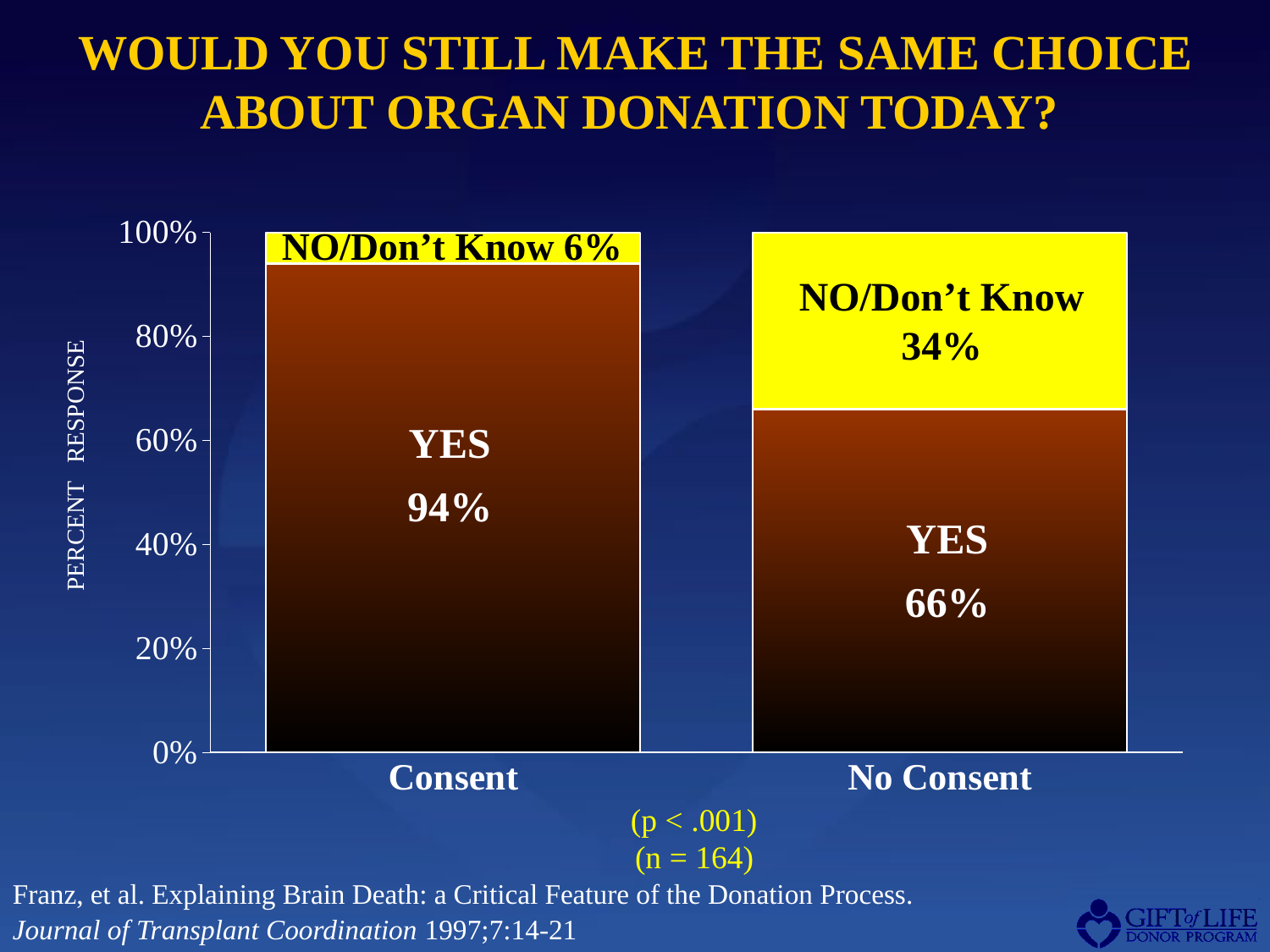
What is the difference in YES percentage between the Consent and No Consent groups? 28% What is the label of the y axis? PERCENT RESPONSE What percentage of the No Consent group answered NO/Don't Know? 34% Which group has the lower NO/Don't Know percentage? Consent What sample size (n) is shown below the chart? n = 164 What type of chart is shown on the slide? Stacked bar chart How many groups (categories) are shown on the x axis? 2 Which group has the higher YES percentage, Consent or No Consent? Consent What percentage of the No Consent group answered YES? 66% What percentage of the Consent group answered YES? 94% What is the difference in NO/Don't Know percentage between the No Consent and Consent groups? 28% What percentage of the Consent group answered NO/Don't Know? 6%